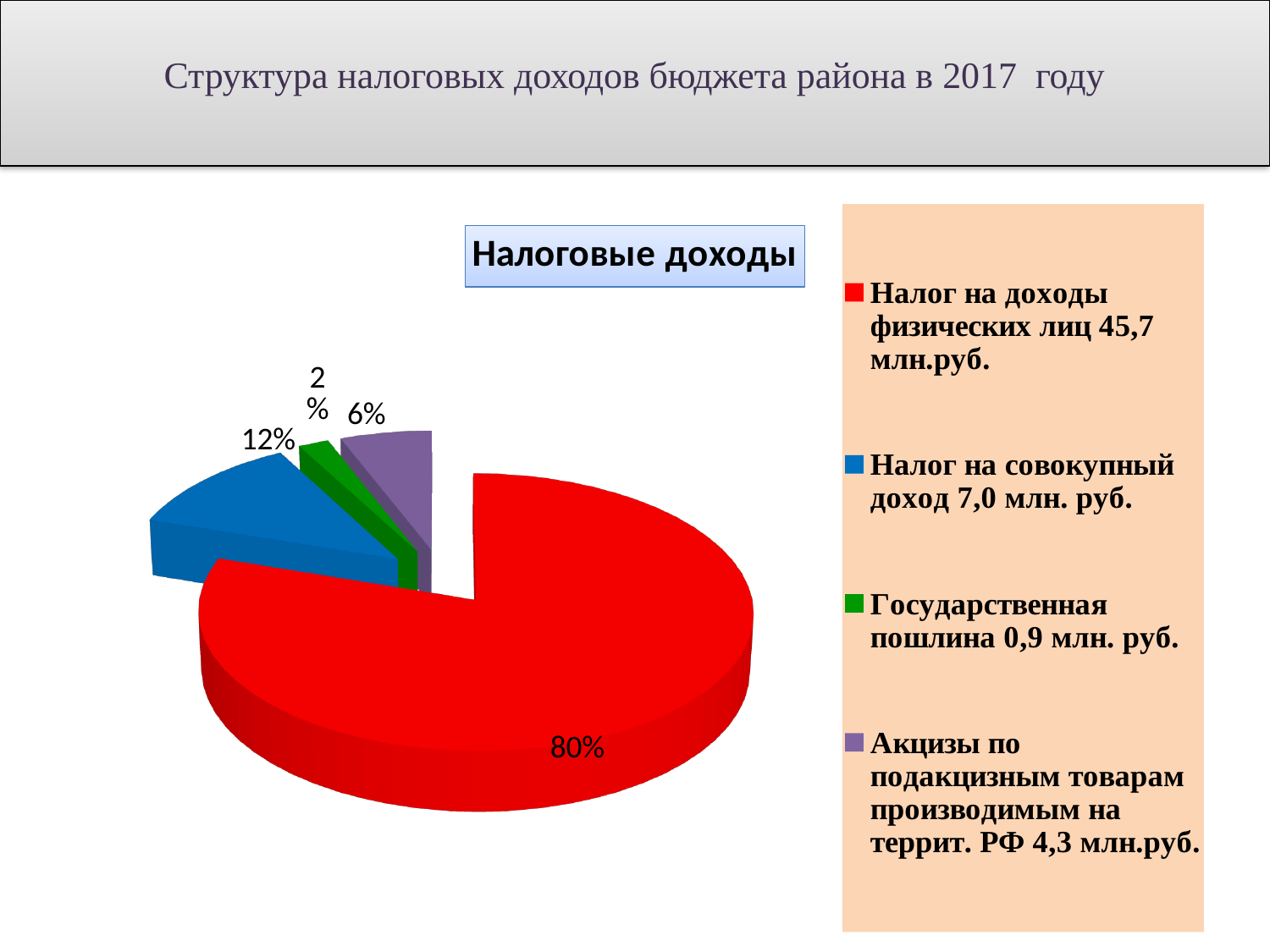
What is the title of the chart? Налоговые доходы Which category has the smallest slice of the pie? Государственная пошлина What type of chart is shown on the slide? pie chart What share of the pie does "Налог на совокупный доход" take? 12% What share of the pie does "Государственная пошлина" take? 2% Which slice is larger: "Акцизы по подакцизным товарам" or "Государственная пошлина"? Акцизы по подакцизным товарам How many slices does the pie chart have? 4 What share of the pie does "Налог на доходы физических лиц" take? 80% What is the difference in percentage points between the "Налог на совокупный доход" slice and the "Акцизы по подакцизным товарам" slice? 6 Which category has the largest slice of the pie? Налог на доходы физических лиц What colour is the slice for "Налог на совокупный доход"? blue